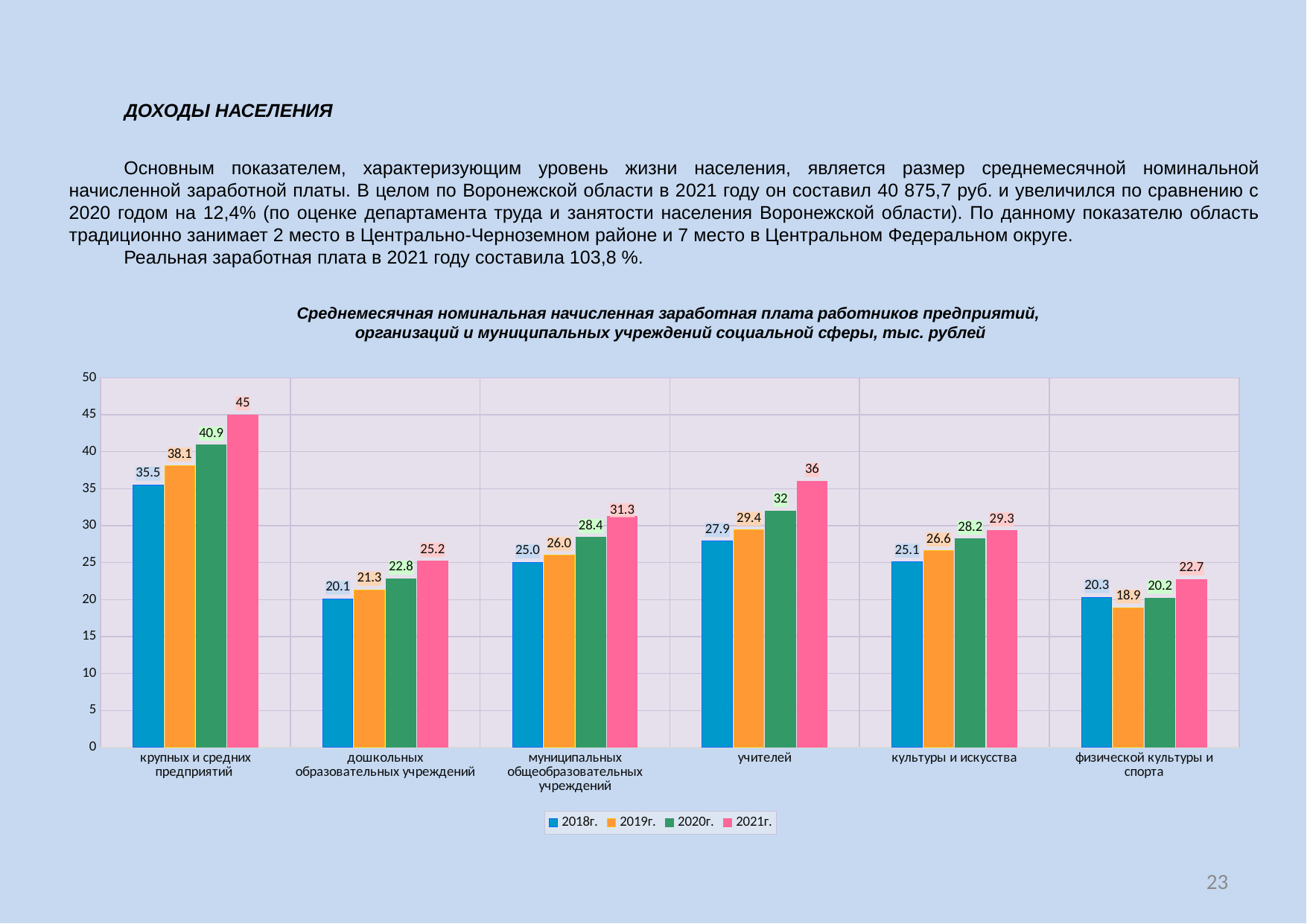
Which category has the lowest value for 2018г.? дошкольных образовательных учреждений For физической культуры и спорта, did the value rise or fall from 2018г. to 2019г.? fall What is the difference between the 2021г. and 2018г. values for учителей? 8.1 Which colour represents the 2021г. series in the legend? pink How many series does the legend list? 4 What is the value for 2020г. for учителей? 32 Which is larger for 2020г.: муниципальных общеобразовательных учреждений or культуры и искусства? муниципальных общеобразовательных учреждений Which category has the highest value for 2021г.? крупных и средних предприятий What is the value for 2019г. for физической культуры и спорта? 18.9 What kind of chart is shown on the slide? bar chart How many categories are shown on the x axis? 6 What is the value for 2021г. for крупных и средних предприятий? 45